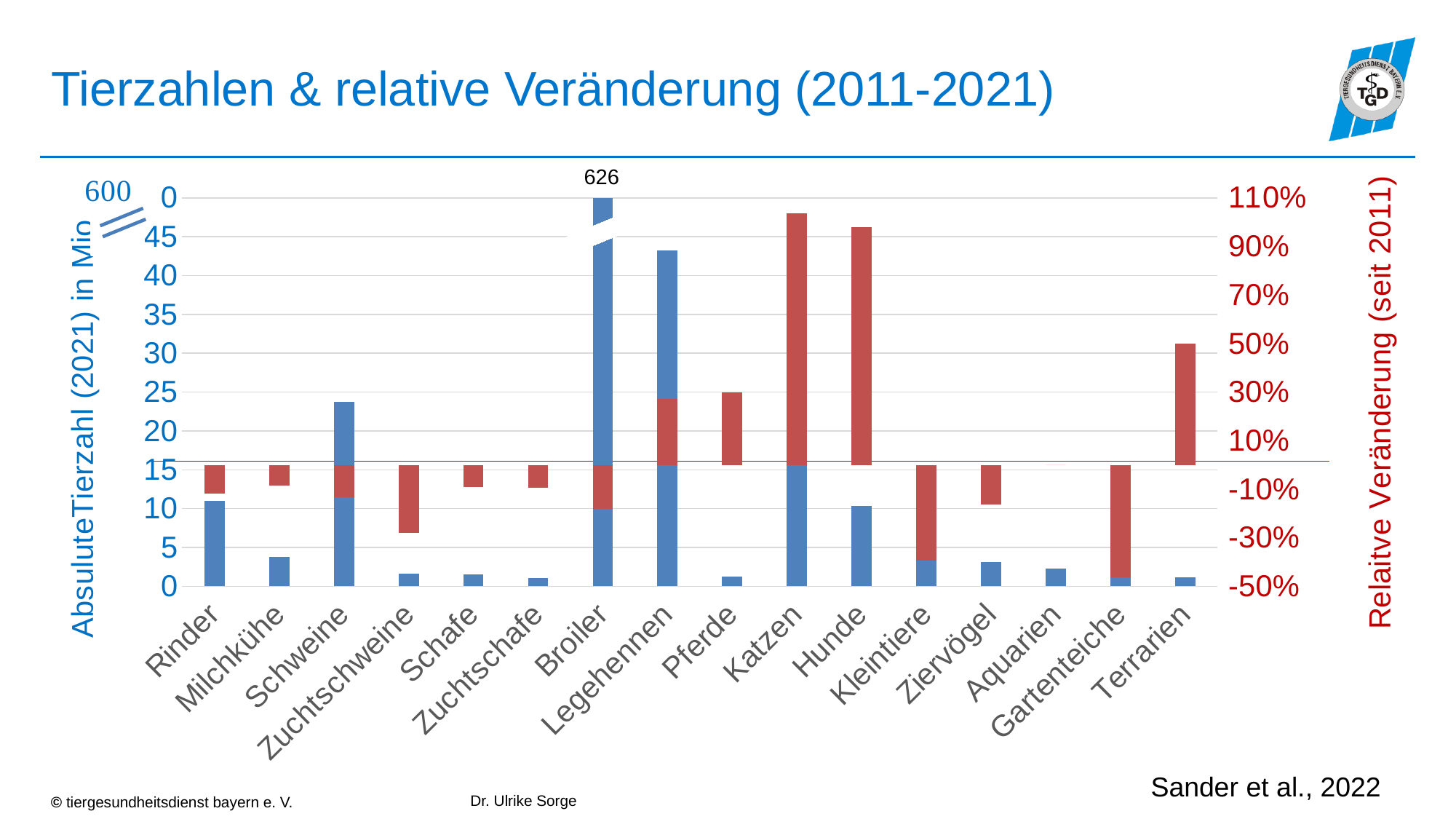
Which category shows the lowest relative change (red bar)? Gartenteiche What kind of chart is shown on the slide? bar chart Is the relative change for Terrarien greater or less than 30%? greater Which has the larger absolute animal number, Schweine or Rinder? Schweine Which has the larger absolute animal number, Katzen or Hunde? Katzen What absolute number (in Mio) is printed above the Broiler bar? 626 Is the absolute animal number for Legehennen greater or less than 40? greater Is the absolute animal number for Schweine greater or less than 20? greater Which category has the highest absolute animal number (blue bar)? Broiler Which category shows the highest relative change (red bar)? Katzen What is the title of the slide? Tierzahlen & relative Veränderung (2011-2021) How many animal categories are shown along the x axis? 16